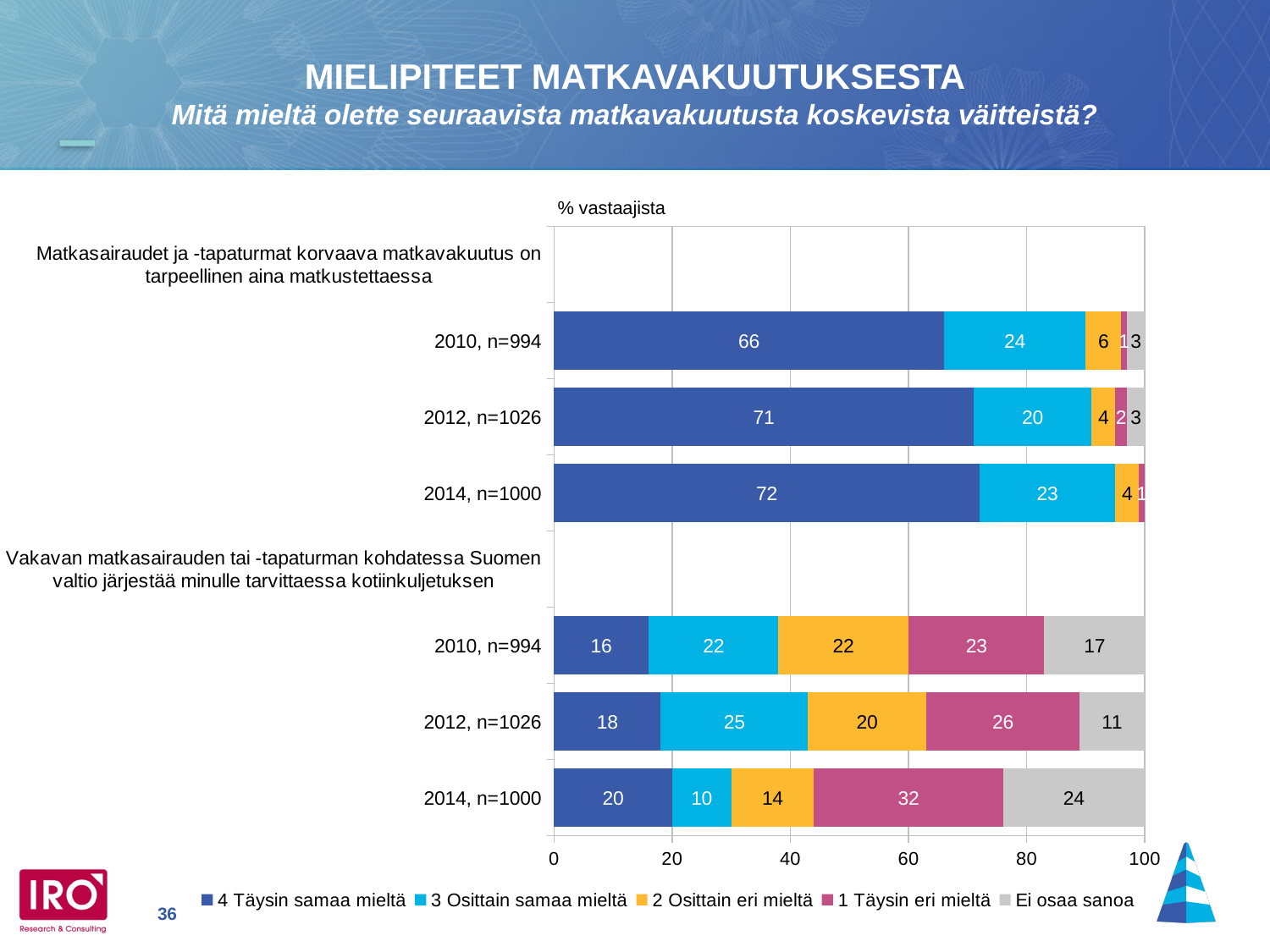
For the statement that travel insurance is always necessary when travelling, what is the value of '4 Täysin samaa mieltä' in 2014, n=1000? 72 For the statement that the Finnish state arranges repatriation, what is the difference between '1 Täysin eri mieltä' in 2014, n=1000 and in 2010, n=994? 9 How many series does the legend list? 5 For the statement that the Finnish state arranges repatriation, what is the value of '1 Täysin eri mieltä' in 2014, n=1000? 32 For the statement that the Finnish state arranges repatriation, what is the total of the stacked bar for 2010, n=994? 100 For the statement that the Finnish state arranges repatriation, what is the value of 'Ei osaa sanoa' in 2012, n=1026? 11 What kind of chart is shown on the slide? Stacked bar chart For the statement that the Finnish state arranges repatriation, which is larger in 2012, n=1026: '3 Osittain samaa mieltä' or '2 Osittain eri mieltä'? 3 Osittain samaa mieltä For the statement that travel insurance is always necessary when travelling, in which year is '4 Täysin samaa mieltä' highest? 2014, n=1000 For the statement that travel insurance is always necessary when travelling, does '4 Täysin samaa mieltä' rise or fall from 2010 to 2014? Rise What is the axis label shown above the chart? % vastaajista For the statement that the Finnish state arranges repatriation, in which year is '3 Osittain samaa mieltä' lowest? 2014, n=1000